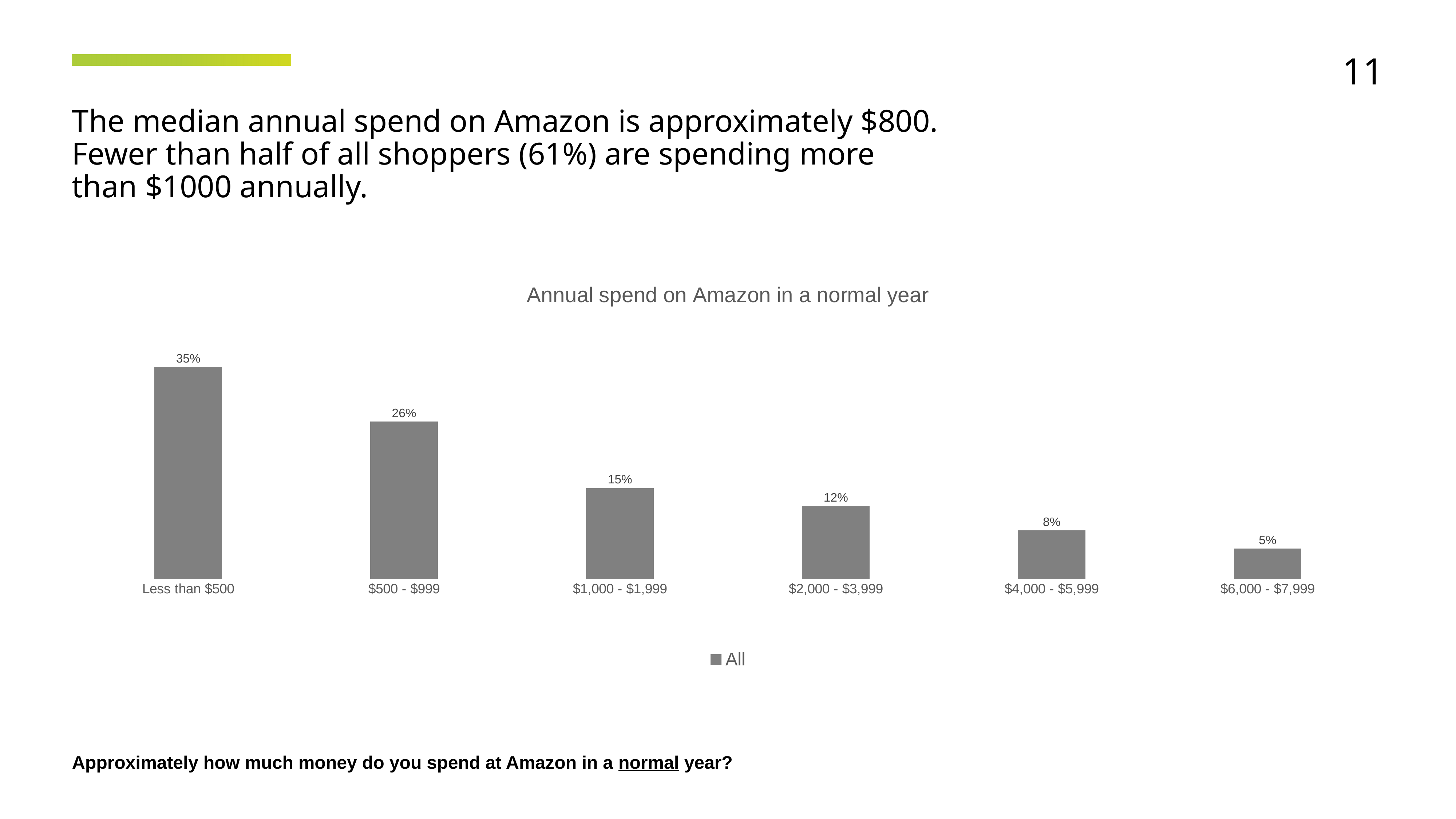
Which spending category has the lowest percentage? $6,000 - $7,999 What kind of chart is shown on the slide? Bar chart How many series does the legend list? 1 What is the value for the $4,000 - $5,999 category? 8% What is the value for the $1,000 - $1,999 category? 15% What percentage of shoppers spend less than $500 on Amazon in a normal year? 35% Which spending category has the highest percentage? Less than $500 Do the values rise or fall as spending categories increase along the x axis? Fall What is the difference between the Less than $500 and $500 - $999 categories? 9% Which is larger, the value for $500 - $999 or the value for $1,000 - $1,999? $500 - $999 What is the difference between the $2,000 - $3,999 and $6,000 - $7,999 categories? 7% How many spending categories are shown on the x axis? 6